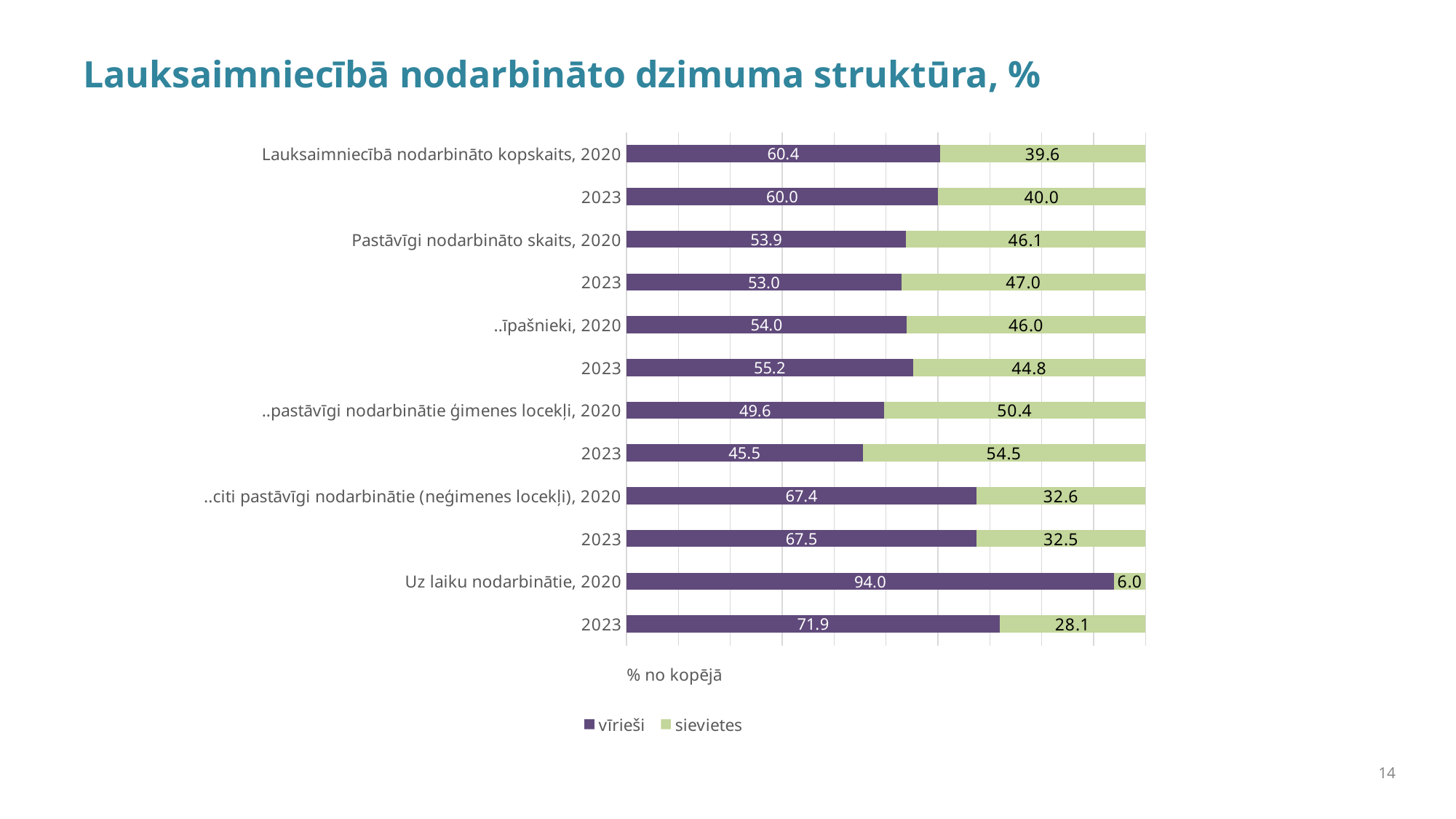
What kind of chart is shown on the slide? stacked bar chart What is the total of the stacked bar for Pastāvīgi nodarbināto skaits, 2020? 100.0 Which bar has the lowest vīrieši value? ..pastāvīgi nodarbinātie ģimenes locekļi, 2023 What is the axis label shown below the chart? % no kopējā What is the vīrieši value for the 2023 bar under ..pastāvīgi nodarbinātie ģimenes locekļi? 45.5 What is the vīrieši value for Lauksaimniecībā nodarbināto kopskaits, 2020? 60.4 Which is larger: the sievietes value for ..īpašnieki, 2020 or the sievietes value for ..īpašnieki, 2023? ..īpašnieki, 2020 How many bars does the chart contain? 12 Which bar has the highest vīrieši value? Uz laiku nodarbinātie, 2020 What is the difference between the vīrieši values for Uz laiku nodarbinātie in 2020 and 2023? 22.1 What is the sievietes value for Uz laiku nodarbinātie, 2020? 6.0 How many series does the legend list? 2